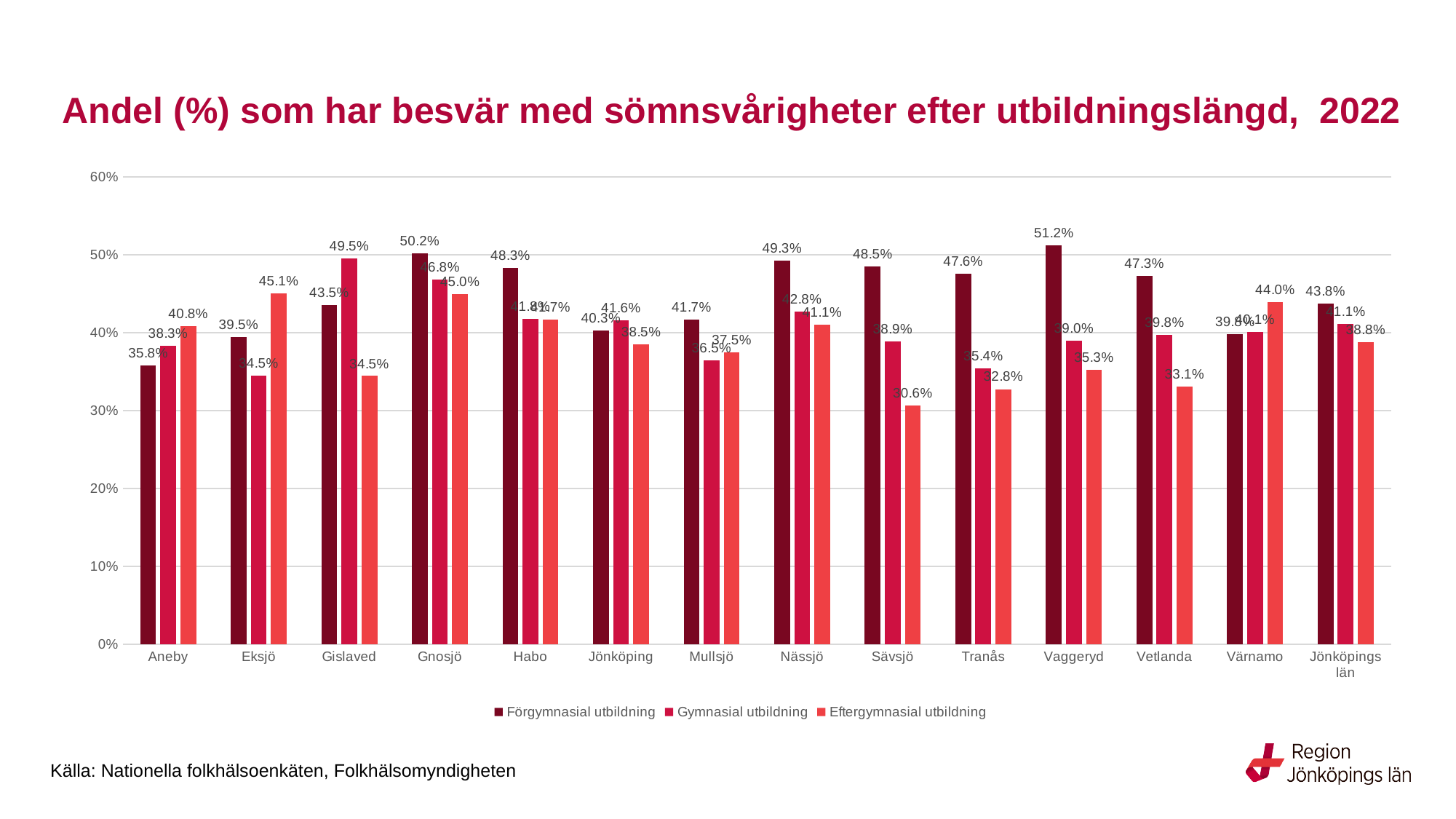
What is the difference between Förgymnasial utbildning and Eftergymnasial utbildning in Sävsjö? 17.9 percentage points What is the value for Eftergymnasial utbildning in Jönköpings län? 38.8% How many series does the legend list? 3 What kind of chart is shown on the slide? Bar chart Which municipality has the highest value for Förgymnasial utbildning? Vaggeryd Which municipality has the lowest value for Eftergymnasial utbildning? Sävsjö What is the value for Gymnasial utbildning in Gislaved? 49.5% Is the value for Eftergymnasial utbildning in Tranås greater or less than 30%? greater How many categories are shown on the x axis? 14 In Aneby, which is larger: Förgymnasial utbildning or Eftergymnasial utbildning? Eftergymnasial utbildning What is the value for Förgymnasial utbildning in Vaggeryd? 51.2% What is the value for Eftergymnasial utbildning in Sävsjö? 30.6%